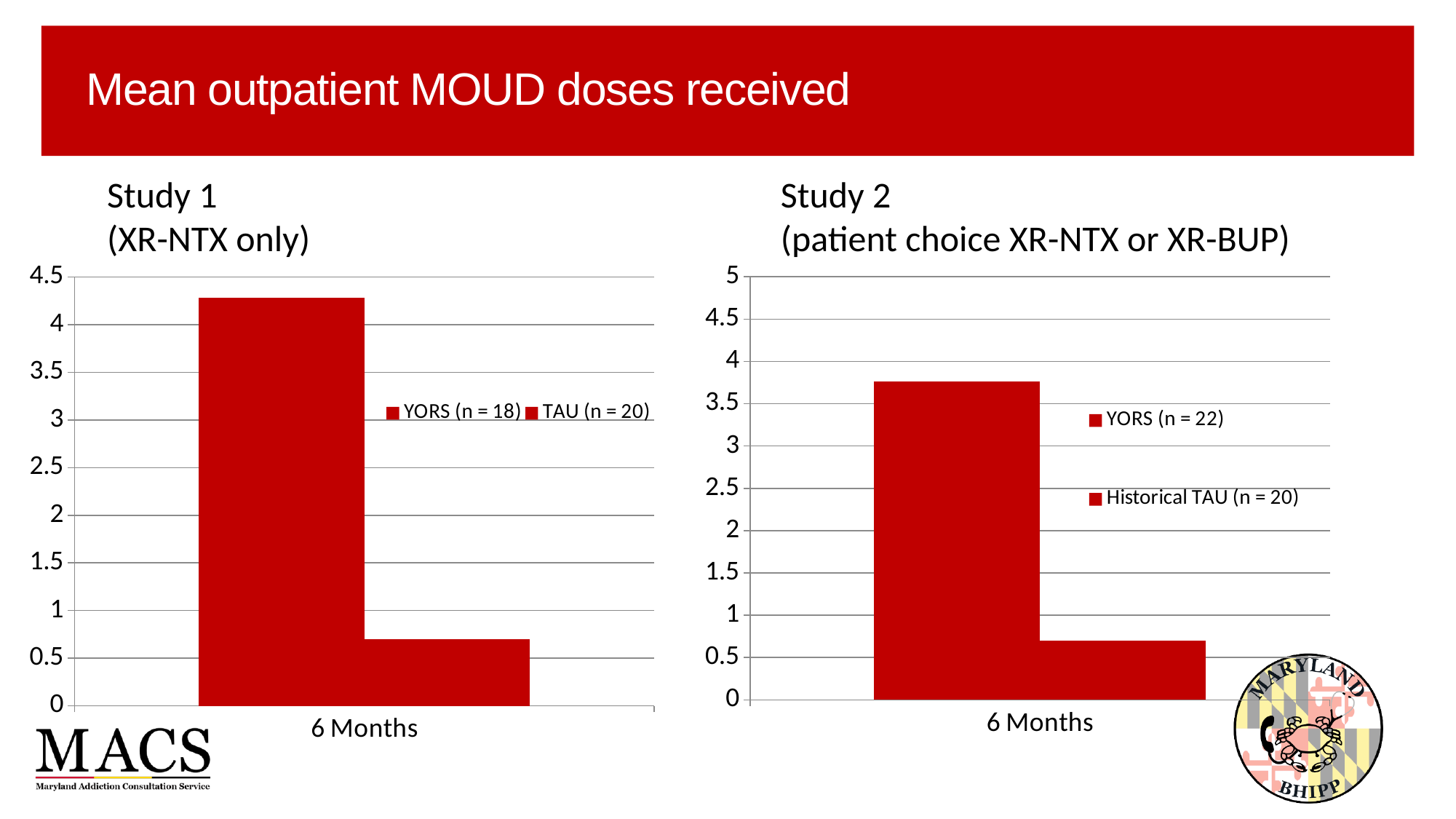
In the Study 2 (patient choice XR-NTX or XR-BUP) chart, how many series does the legend list? 2 In the Study 1 (XR-NTX only) chart, which series has the higher value: YORS (n = 18) or TAU (n = 20)? YORS (n = 18) In the Study 2 (patient choice XR-NTX or XR-BUP) chart, is the value for Historical TAU (n = 20) greater or less than 1? less What kind of chart is the Study 1 (XR-NTX only) chart? bar chart In the Study 2 (patient choice XR-NTX or XR-BUP) chart, is the value for YORS (n = 22) greater or less than 3.5? greater In the Study 1 (XR-NTX only) chart, is the value for YORS (n = 18) greater or less than 4? greater What is the x-axis category label in the Study 2 (patient choice XR-NTX or XR-BUP) chart? 6 Months In the Study 1 (XR-NTX only) chart, how many categories are shown on the x axis? 1 In the Study 1 (XR-NTX only) chart, how many series does the legend list? 2 What is the title of the slide containing the two charts? Mean outpatient MOUD doses received In the Study 2 (patient choice XR-NTX or XR-BUP) chart, which series has the lowest value? Historical TAU (n = 20)